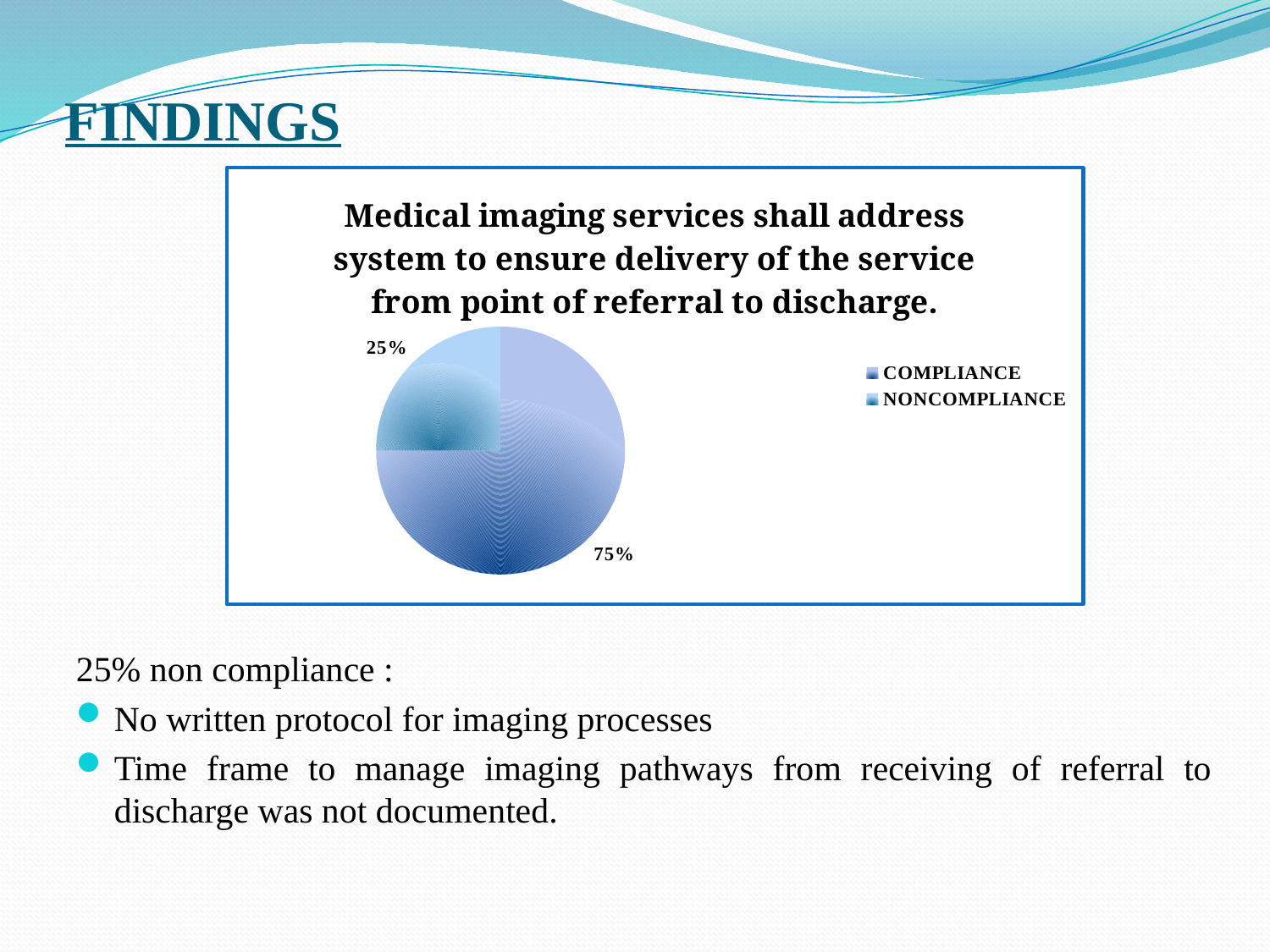
What percentage of the pie is labelled for NONCOMPLIANCE? 25% How many entries does the chart legend list? 2 Which is larger, the COMPLIANCE slice or the NONCOMPLIANCE slice? COMPLIANCE What percentage of the pie is labelled for COMPLIANCE? 75% Which slice of the pie is the smallest? NONCOMPLIANCE What is the title of the pie chart? Medical imaging services shall address system to ensure delivery of the service from point of referral to discharge. Which slice of the pie is the largest? COMPLIANCE What share of the pie does the NONCOMPLIANCE slice represent? 25% How many slices does the pie chart have? 2 What is the difference in percentage points between the COMPLIANCE and NONCOMPLIANCE slices? 50 What is the first legend entry listed for the pie chart? COMPLIANCE What kind of chart is shown on the slide? pie chart